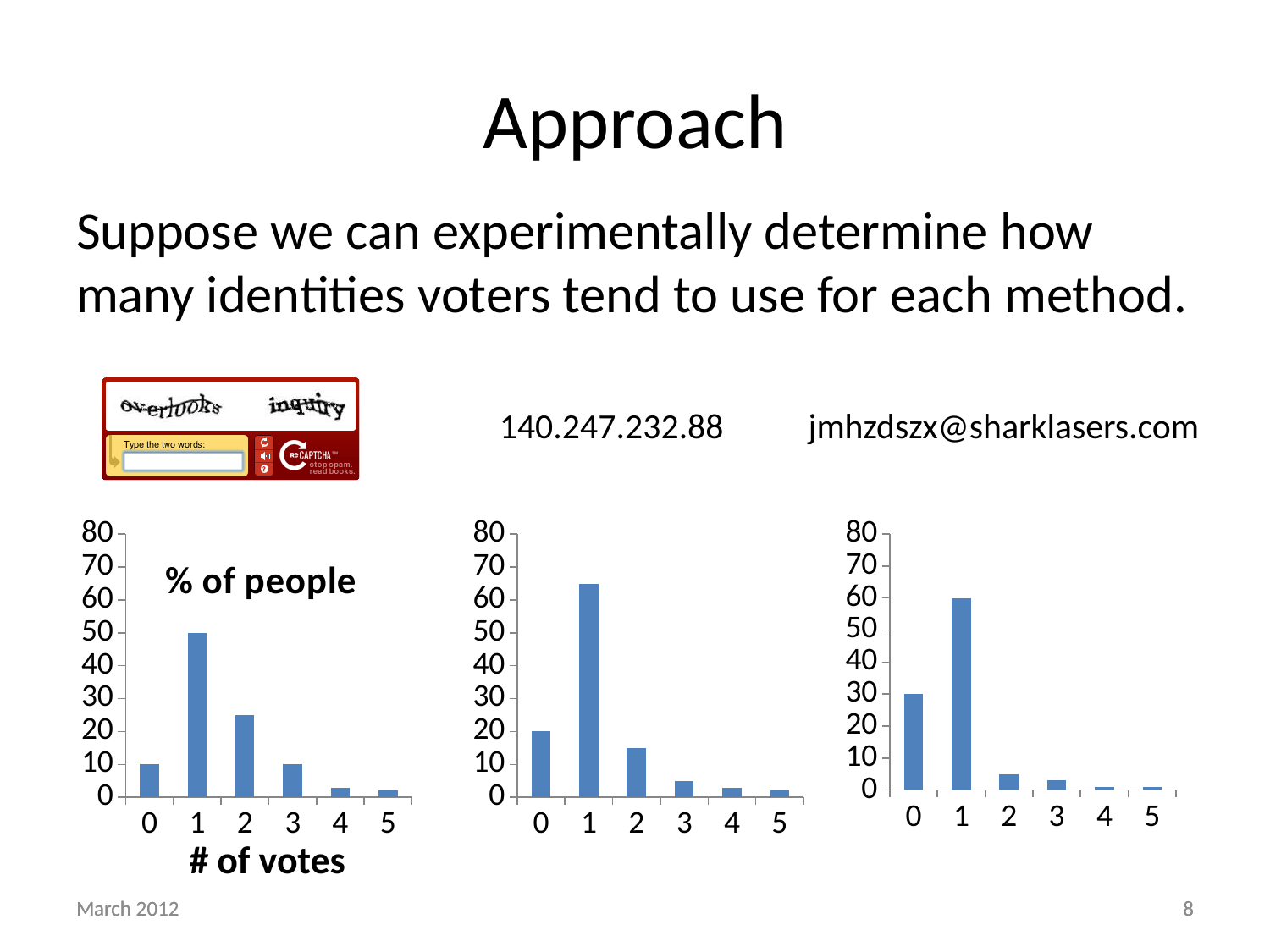
In the middle chart (140.247.232.88), is the value for 1 vote greater or less than 60? greater In the middle chart (140.247.232.88), which number of votes has the highest bar? 1 In the right chart (jmhzdszx@sharklasers.com), what is the value for 1 vote? 60 In the middle chart (140.247.232.88), do the values rise or fall from 1 vote to 5 votes? fall In the right chart (jmhzdszx@sharklasers.com), is the value for 2 votes greater or less than 10? less In the left chart, what is the value for 1 vote? 50 In the right chart (jmhzdszx@sharklasers.com), which number of votes has the highest bar? 1 In the middle chart (140.247.232.88), what is the value for 0 votes? 20 In the left chart, how many categories are shown on the x axis? 6 In the right chart (jmhzdszx@sharklasers.com), which is larger: the value for 0 votes or the value for 2 votes? 0 votes What kind of chart is the left chart (the one labelled '% of people')? bar chart In the left chart, which number of votes has the highest percentage of people? 1